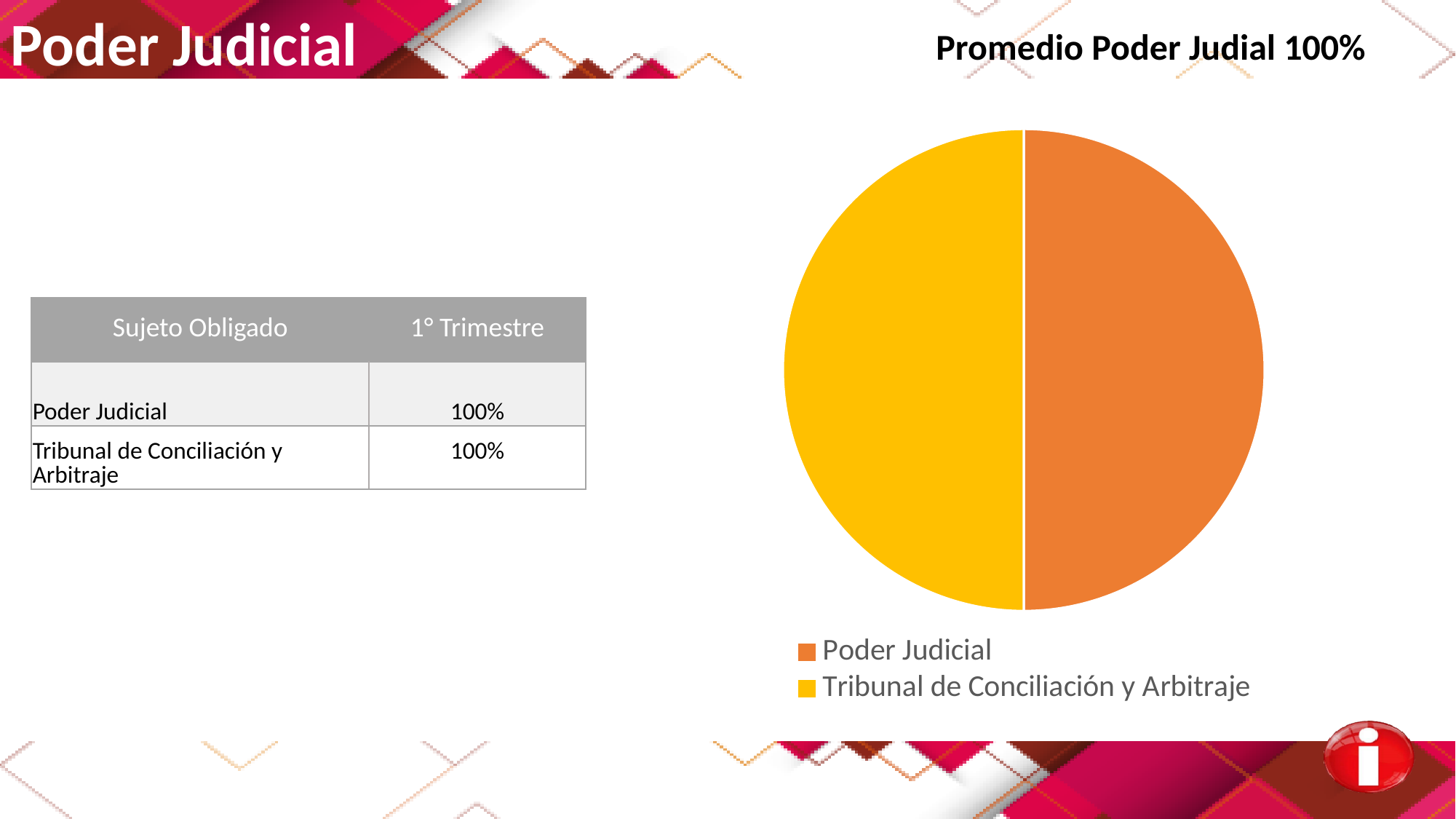
What kind of chart is shown on the slide? pie chart According to the table on the slide, what is the 1° Trimestre value for Tribunal de Conciliación y Arbitraje? 100% How many slices does the pie chart have? 2 What is the title shown above the pie chart? Promedio Poder Judial 100% Which colour represents Poder Judicial in the pie chart? orange What is the difference between the 1° Trimestre values for Poder Judicial and Tribunal de Conciliación y Arbitraje shown in the table? 0% How many entries does the legend of the pie chart list? 2 According to the table on the slide, what is the 1° Trimestre value for Poder Judicial? 100%